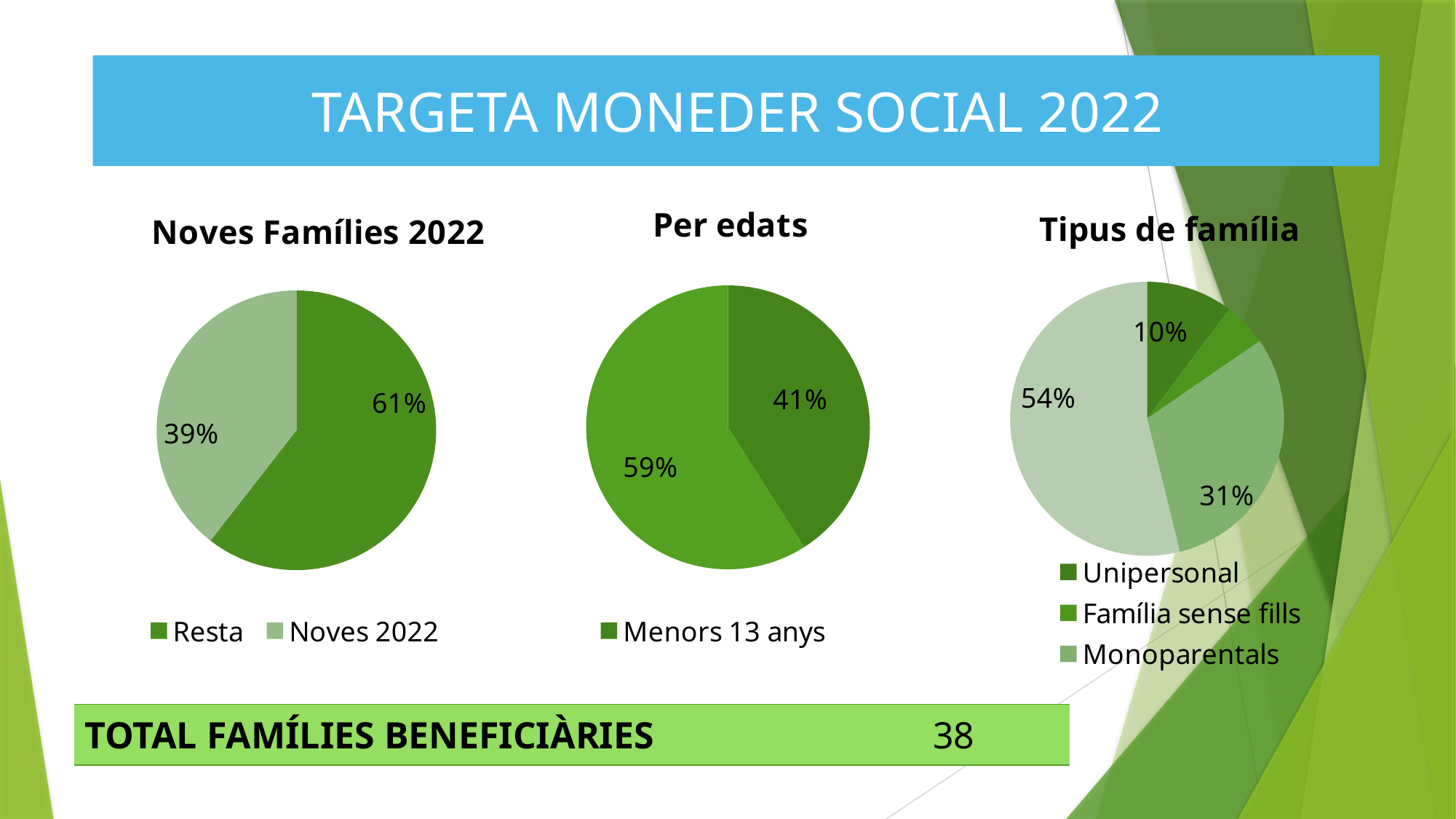
What type of chart is used for 'Noves Famílies 2022'? Pie chart In the 'Noves Famílies 2022' chart, what is the difference in percentage points between Resta and Noves 2022? 22 In the 'Per edats' chart, is the share for Menors 13 anys greater or less than 50%? less In the 'Noves Famílies 2022' chart, what percentage is shown for Noves 2022? 39% In the 'Tipus de família' chart, what is the percentage of the largest slice? 54% In the 'Per edats' chart, what percentage is shown for Menors 13 anys? 41% In the 'Tipus de família' chart, what percentage is shown for Unipersonal? 10% How many charts are shown on the slide? 3 In the 'Noves Famílies 2022' chart, what percentage is shown for Resta? 61% In the 'Per edats' chart, what is the percentage of the larger slice? 59% How many entries does the legend of the 'Tipus de família' chart list? 3 In the 'Noves Famílies 2022' chart, which category has the larger share? Resta